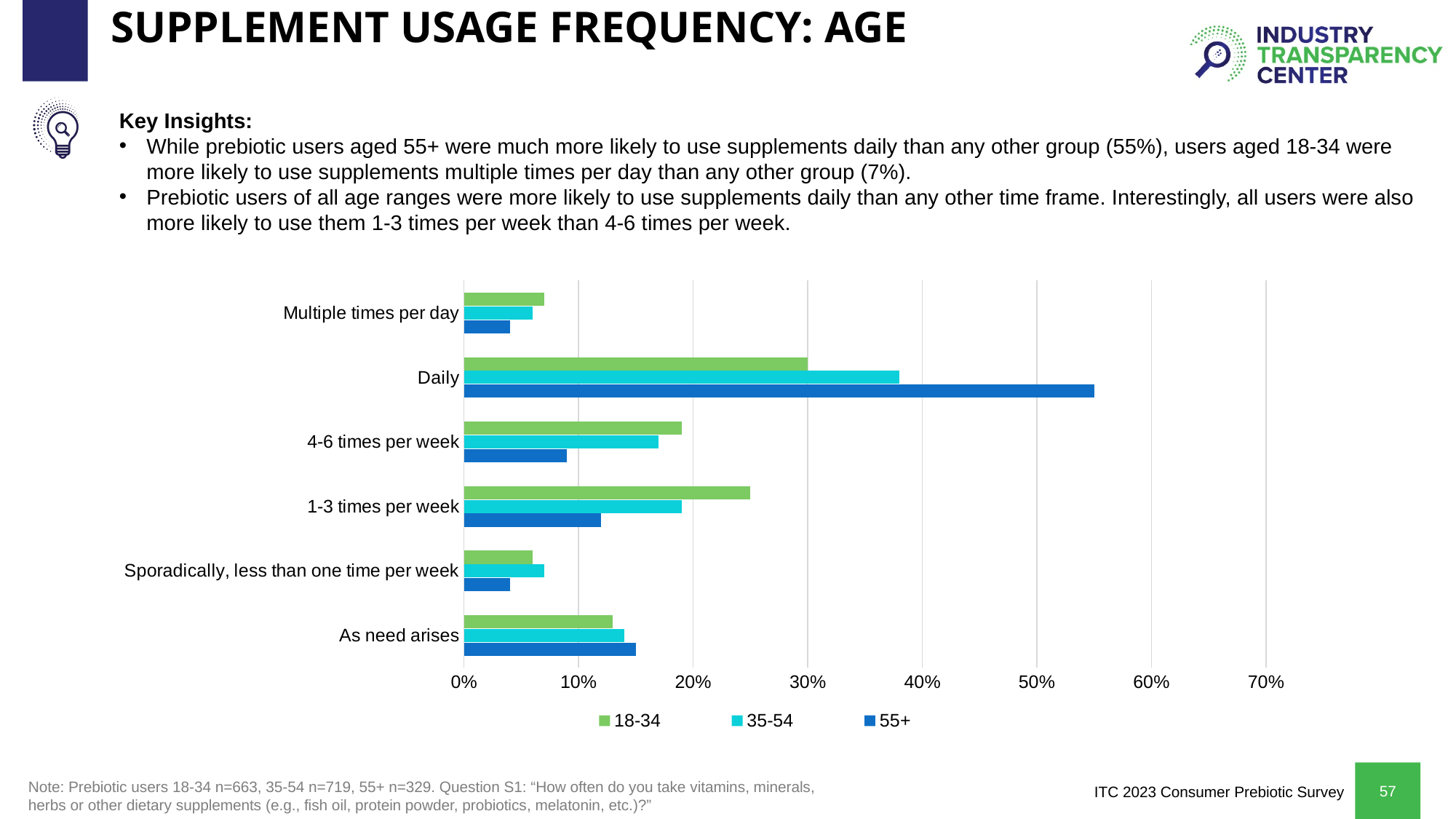
What percentage of prebiotic users aged 55+ use supplements daily? 55% Is the value for 18-34 users using supplements 1-3 times per week greater or less than 20%? greater How many usage-frequency categories are plotted on the chart? 6 For 1-3 times per week, which age group has the larger value, 18-34 or 55+? 18-34 How many age groups does the legend list? 3 Which usage frequency has the highest value for the 55+ group? Daily What kind of chart is shown on the slide? bar chart Which age group has the highest value for Daily usage? 55+ What percentage of prebiotic users aged 18-34 use supplements multiple times per day? 7% Is the value for 35-54 Daily usage greater or less than 30%? greater Which age group is shown in green in the legend? 18-34